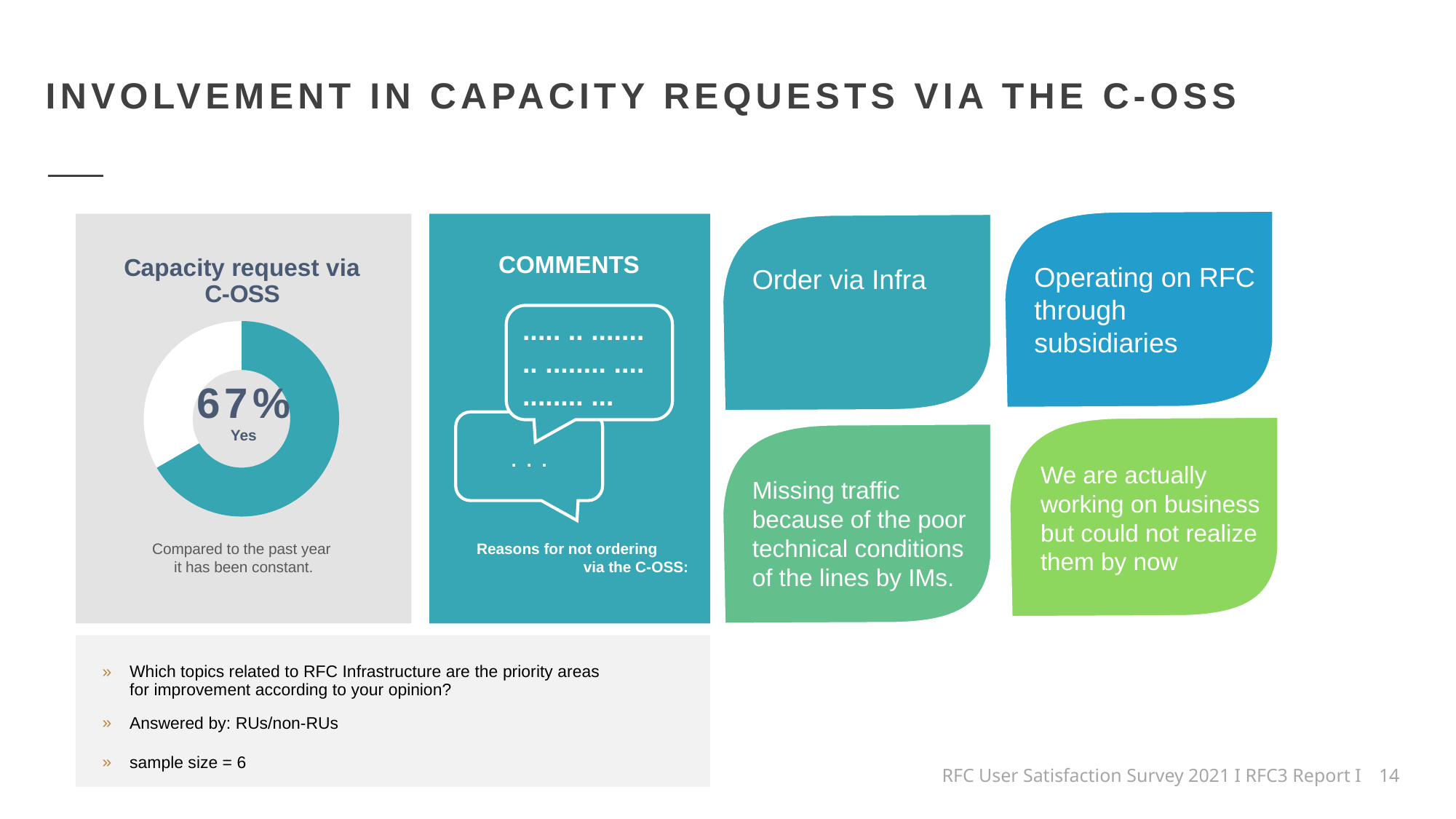
What is the title of the donut chart? Capacity request via C-OSS What kind of chart is shown under the heading "Capacity request via C-OSS"? Pie chart (donut) What share of the donut chart does the "Yes" slice represent? 67% What percentage of respondents answered "Yes" to making capacity requests via the C-OSS? 67% How many segments does the donut chart have? 2 According to the text below the donut chart, how has the result changed compared to the past year? It has been constant In the donut chart, which is larger: the "Yes" slice or the remaining slice? Yes Is the "Yes" share in the donut chart greater or less than 50%? greater